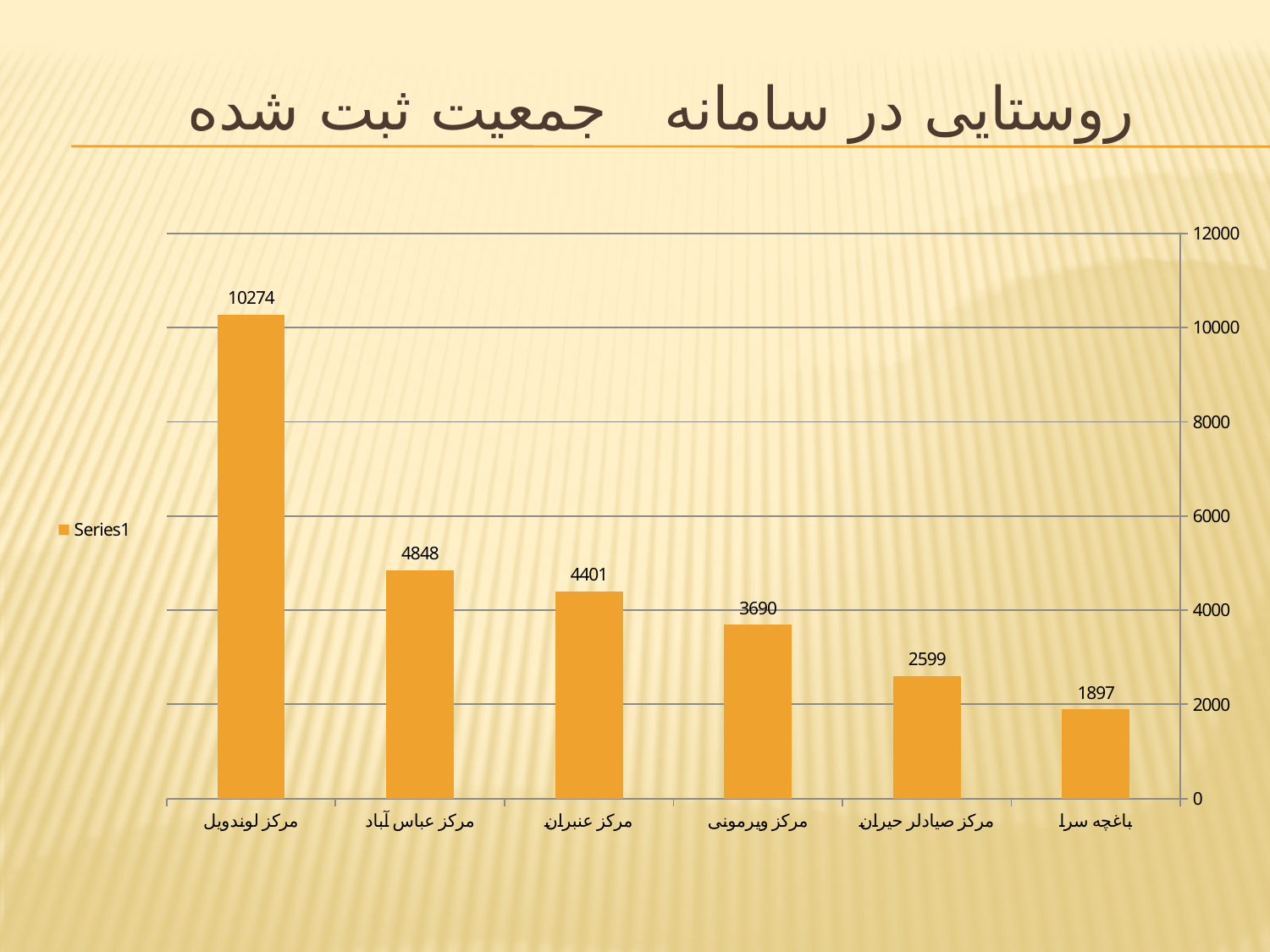
How many series does the legend list? 1 What is the value for مرکز لوندویل? 10274 Which category has the highest value? مرکز لوندویل What is the value for مرکز ویرمونی? 3690 What type of chart is shown on the slide? bar chart What is the value for مرکز عباس آباد? 4848 What is the difference between the values for مرکز لوندویل and باغچه سرا? 8377 How many categories are shown on the x axis? 6 What is the value for باغچه سرا? 1897 Which is larger, the value for مرکز صیادلر حیران or the value for مرکز ویرمونی? مرکز ویرمونی What is the difference between the values for مرکز عباس آباد and مرکز عنبران? 447 Which category has the lowest value? باغچه سرا